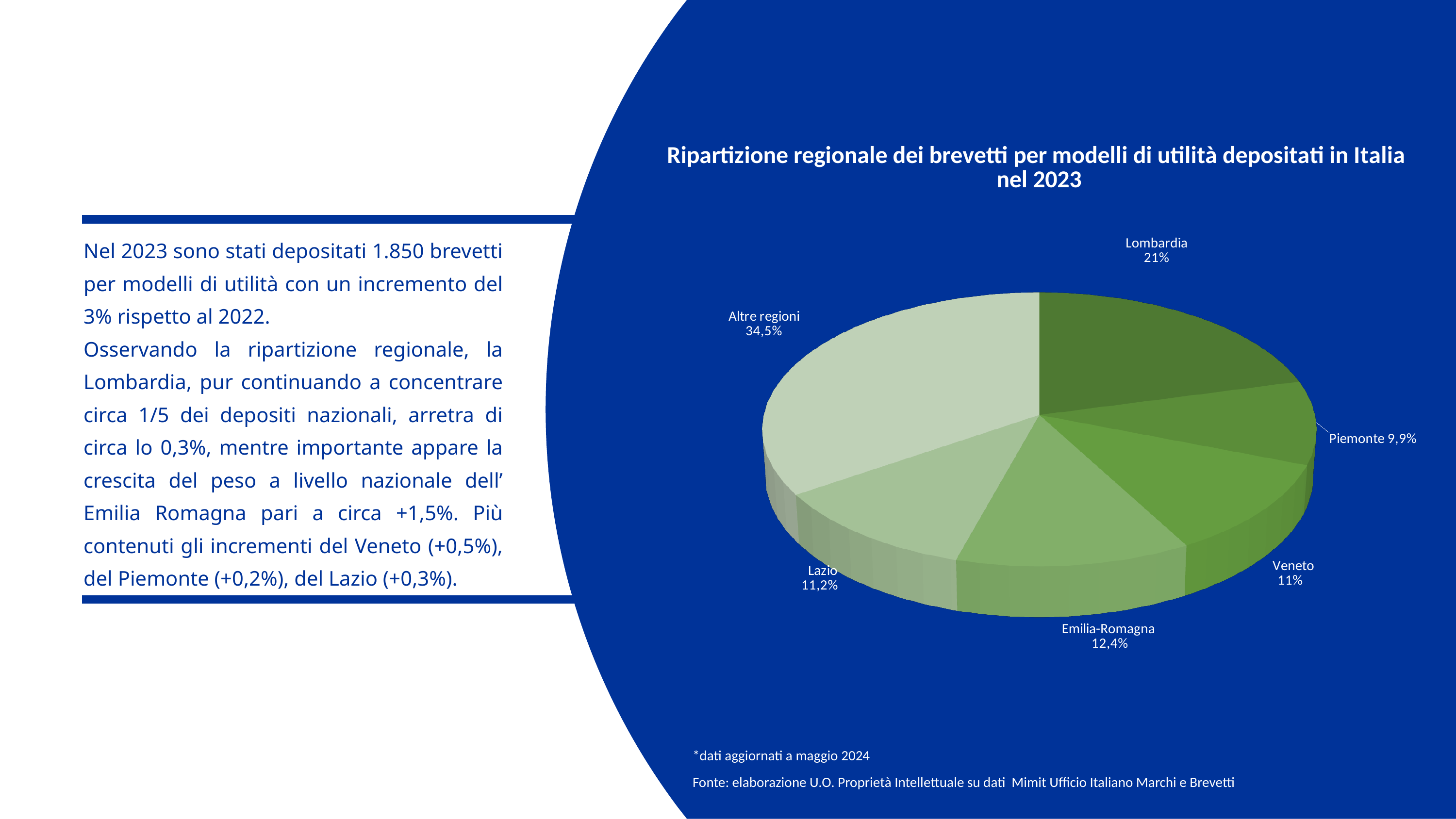
Which is larger, the slice for Emilia-Romagna or the slice for Veneto? Emilia-Romagna How many slices does the pie chart have? 6 What is the difference in percentage points between Lombardia and Piemonte? 11,1 What is the combined share of Lombardia and Veneto? 32% What is the title of the chart? Ripartizione regionale dei brevetti per modelli di utilità depositati in Italia nel 2023 What share of the pie does Lombardia account for? 21% What is the value shown for Emilia-Romagna? 12,4% Which slice of the pie is the largest? Altre regioni What is the value for Lazio? 11,2% What percentage is shown for Piemonte? 9,9% Which named region has the smallest slice? Piemonte What kind of chart is shown on the slide? Pie chart